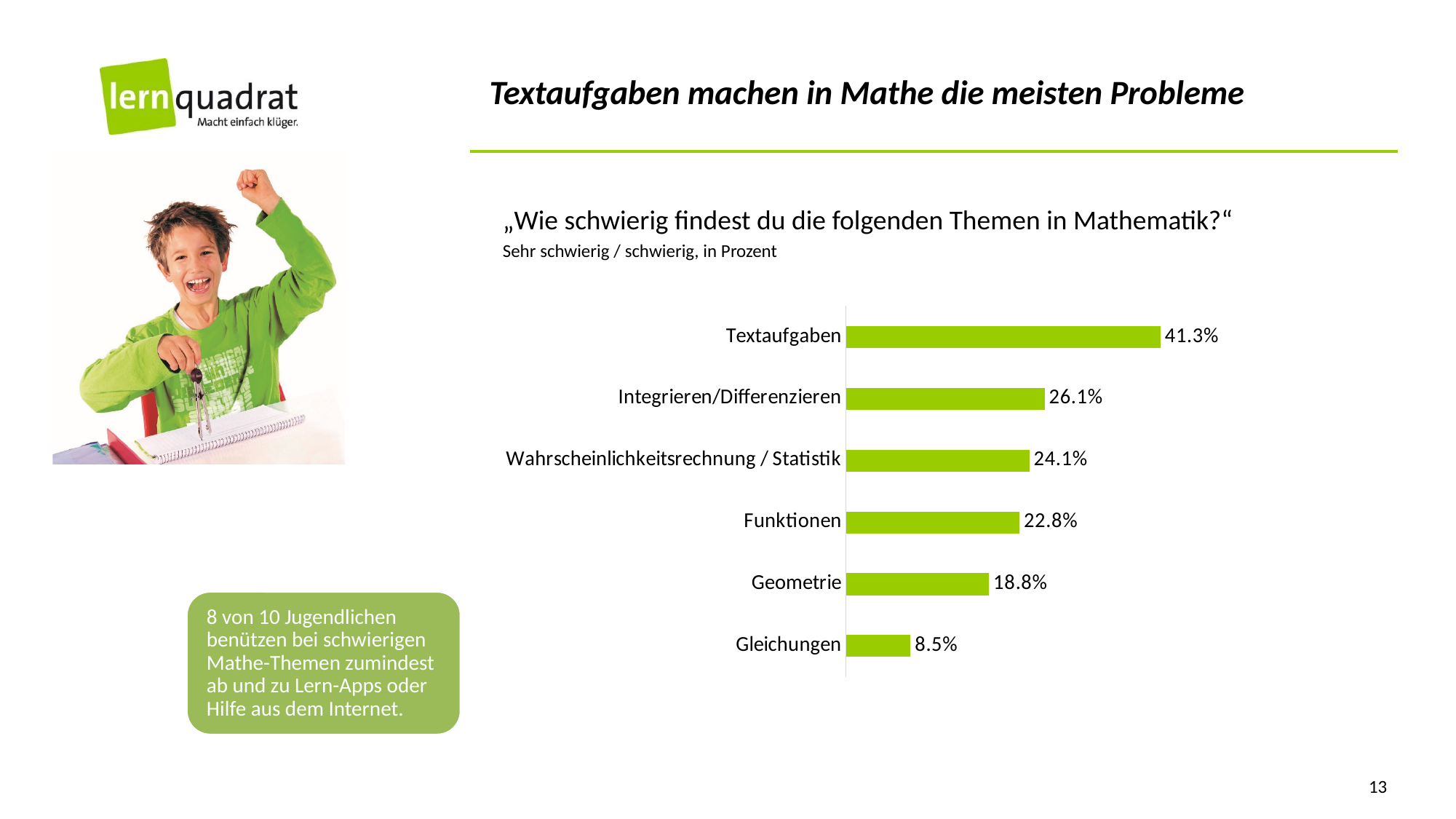
What is the value for Textaufgaben? 41.3% What is the value for Geometrie? 18.8% What is the difference between the values for Textaufgaben and Gleichungen? 32.8% What is the difference between the values for Funktionen and Geometrie? 4.0% Which is larger, the value for Funktionen or the value for Geometrie? Funktionen How many categories are shown in the chart? 6 What question is the chart based on, as stated above it? „Wie schwierig findest du die folgenden Themen in Mathematik?“ What is the value for Integrieren/Differenzieren? 26.1% Which category has the lowest value? Gleichungen Which category has the highest value? Textaufgaben What kind of chart is shown on the slide? Bar chart What is the value for Wahrscheinlichkeitsrechnung / Statistik? 24.1%